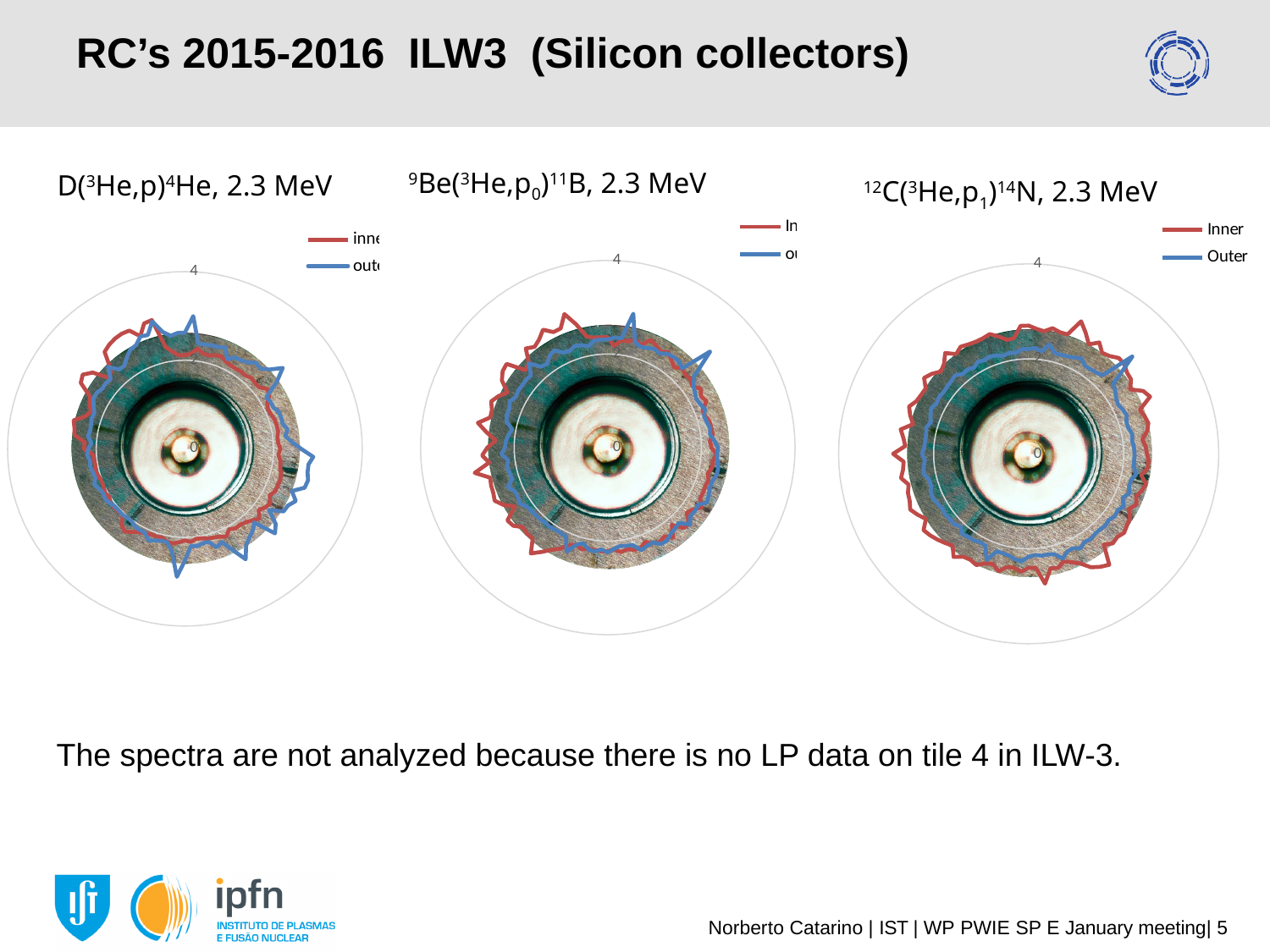
In the 9Be(3He,p0)11B, 2.3 MeV chart, are the plotted values of the inner series greater or less than 4? less What value is labelled at the centre of the D(3He,p)4He, 2.3 MeV chart? 0 What are the two legend entries of the 12C(3He,p1)14N, 2.3 MeV chart? Inner and Outer How many series does the legend of the D(3He,p)4He, 2.3 MeV chart list? 2 How many charts are shown on the slide? 3 In the 12C(3He,p1)14N, 2.3 MeV chart, which colour is used for the Inner series? red What kind of chart is used for the D(3He,p)4He, 2.3 MeV plot? radar chart How many series does the legend of the 12C(3He,p1)14N, 2.3 MeV chart list? 2